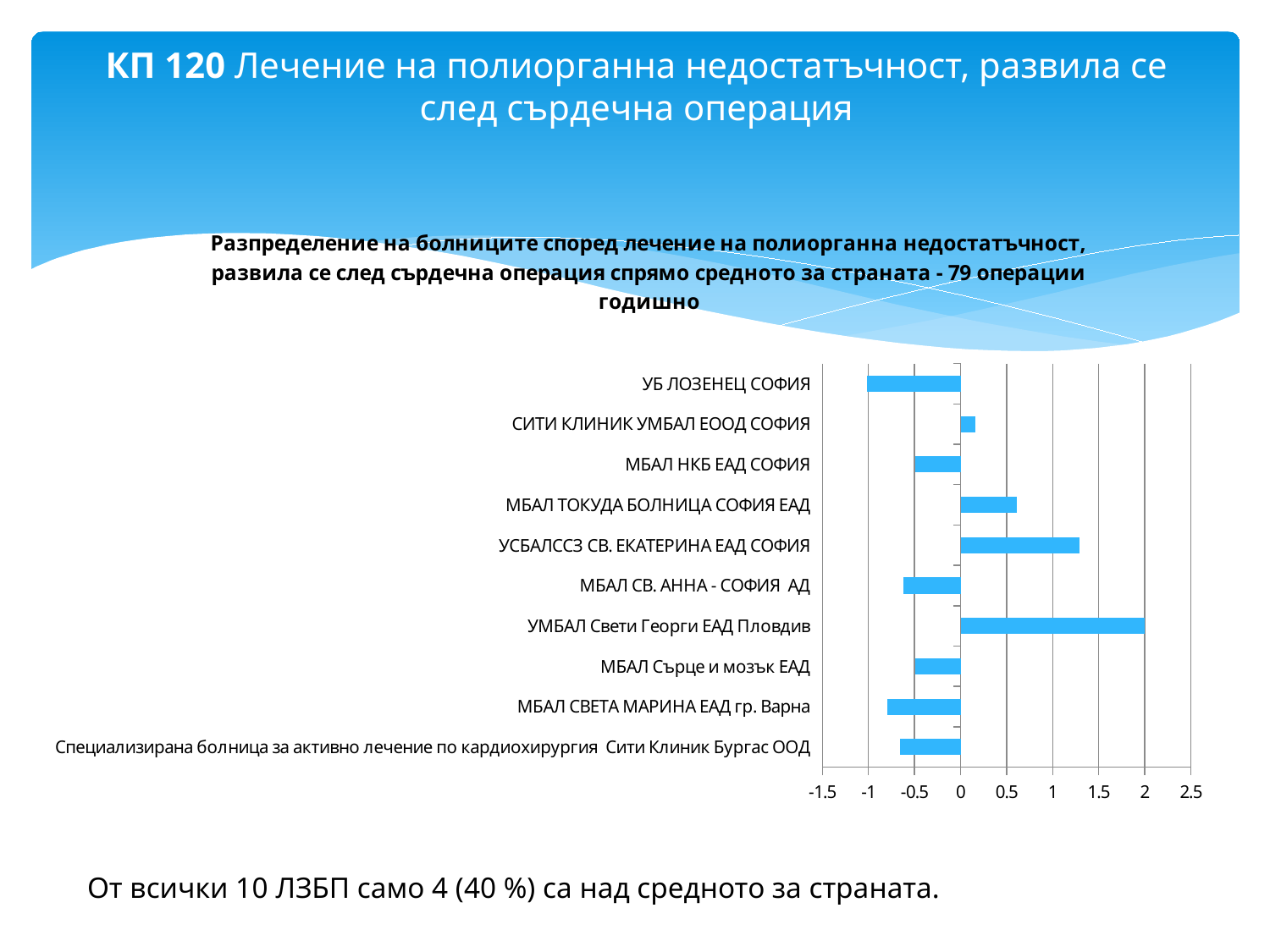
Is the value for СИТИ КЛИНИК УМБАЛ ЕООД СОФИЯ greater or less than 0.5? less Which hospital has the lowest value in the chart? УБ ЛОЗЕНЕЦ СОФИЯ Is the value for МБАЛ СВЕТА МАРИНА ЕАД гр. Варна greater or less than -0.5? less Which has the larger value: УСБАЛССЗ СВ. ЕКАТЕРИНА ЕАД СОФИЯ or МБАЛ ТОКУДА БОЛНИЦА СОФИЯ ЕАД? УСБАЛССЗ СВ. ЕКАТЕРИНА ЕАД СОФИЯ How many hospitals (categories) are plotted in the chart? 10 What kind of chart is shown on the slide? bar chart Which hospital has the highest value in the chart? УМБАЛ Свети Георги ЕАД Пловдив Is the value for УСБАЛССЗ СВ. ЕКАТЕРИНА ЕАД СОФИЯ greater or less than 1? greater According to the chart title, what is the national average number of operations per year? 79 операции годишно How many hospitals have a positive value (bar extending to the right of 0) in the chart? 4